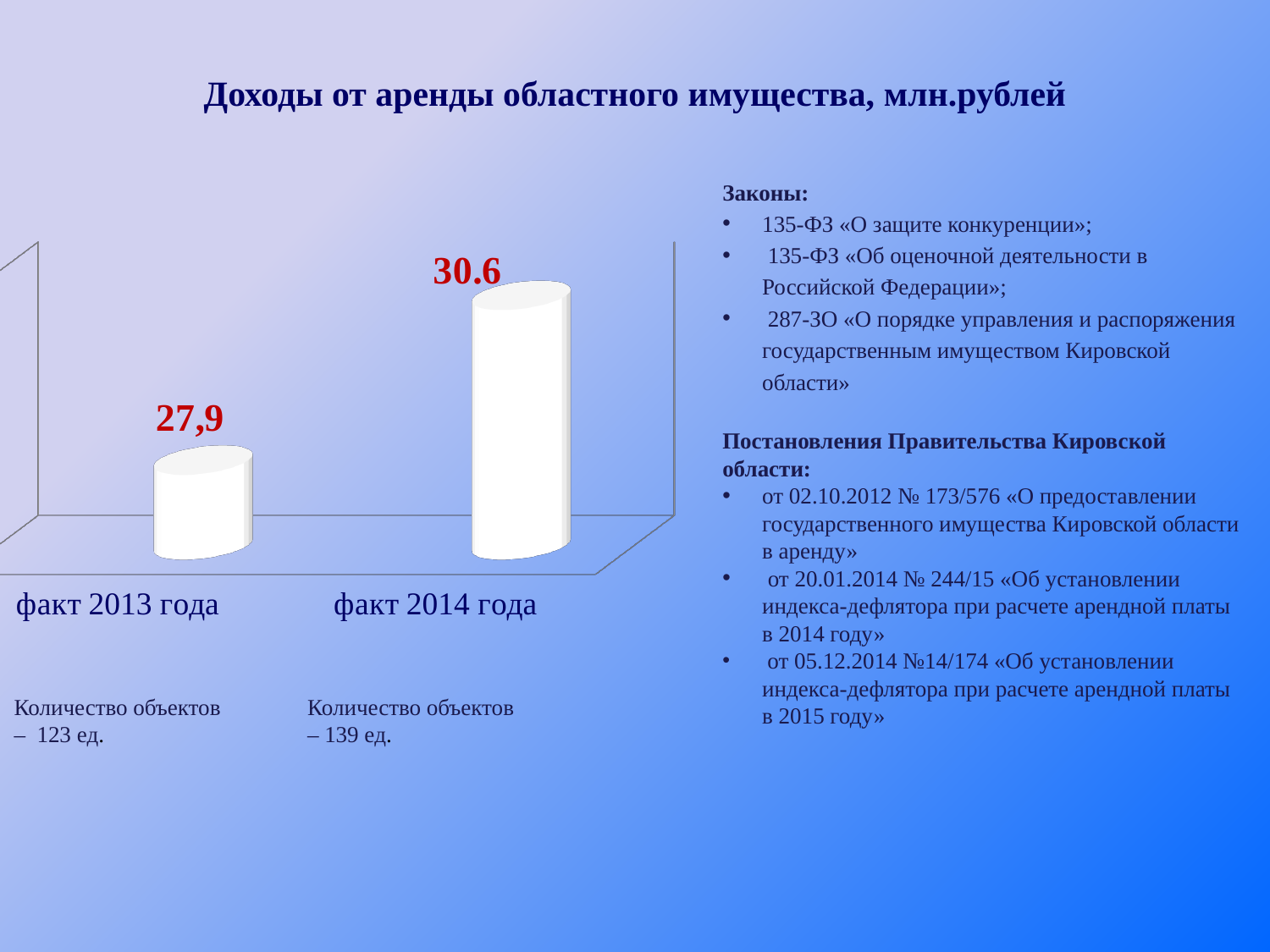
Which is larger, the value for факт 2013 года or факт 2014 года? факт 2014 года What is the difference between the values for факт 2014 года and факт 2013 года? 2.7 Which category has the lowest value? факт 2013 года What is the title of the chart? Доходы от аренды областного имущества, млн.рублей Do the values rise or fall from факт 2013 года to факт 2014 года? rise What kind of chart is shown on the slide? bar chart What is the value for факт 2014 года? 30.6 What colour are the bars in the chart? white How many categories are shown in the chart? 2 Which category has the highest value? факт 2014 года What is the value for факт 2013 года? 27,9